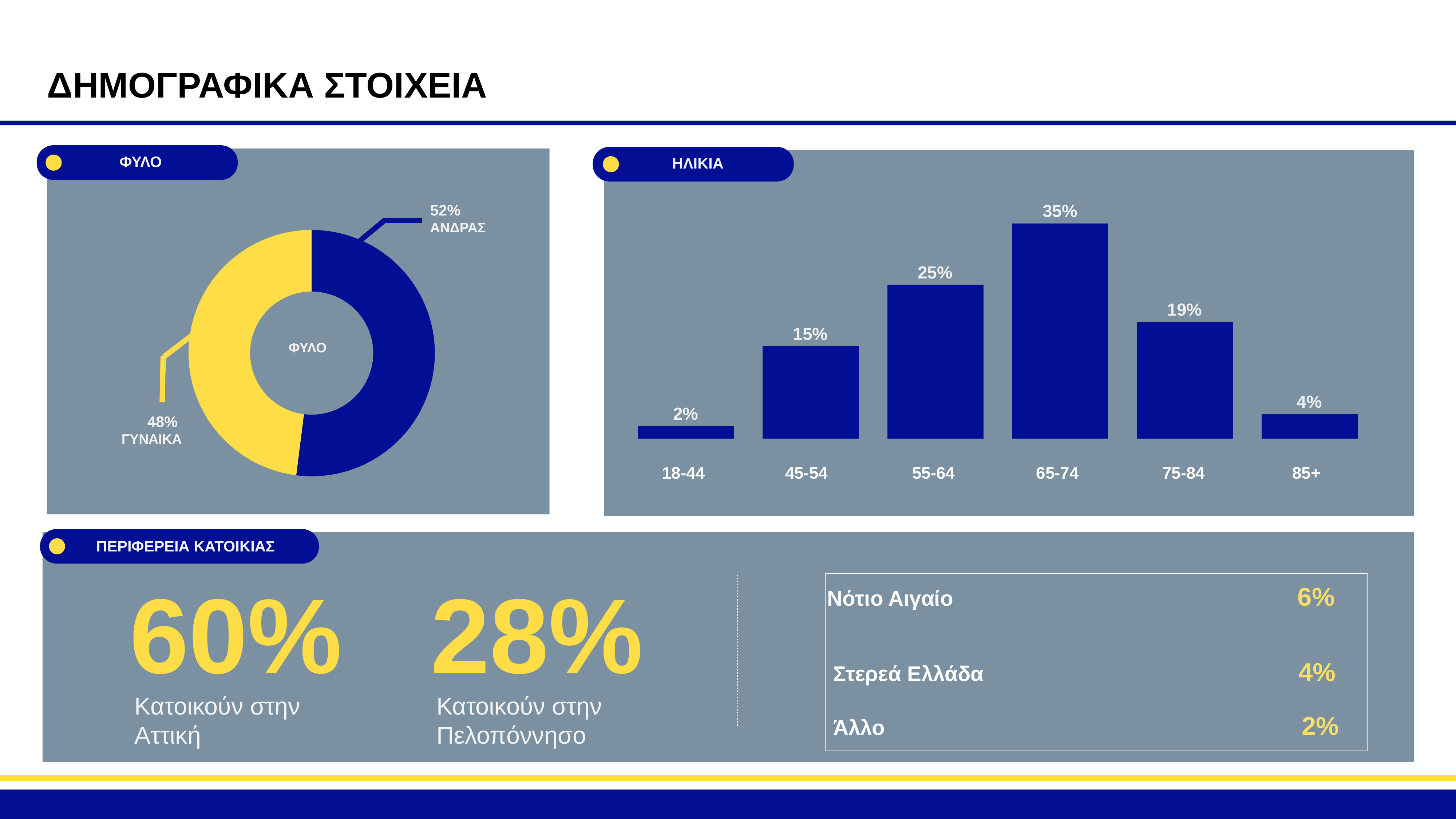
In the ΗΛΙΚΙΑ chart, which age group has the highest value? 65-74 In the ΦΥΛΟ chart, what percentage is ΓΥΝΑΙΚΑ? 48% In the ΦΥΛΟ chart, what percentage is ΑΝΔΡΑΣ? 52% In the ΗΛΙΚΙΑ chart, how many age groups are shown? 6 In the ΗΛΙΚΙΑ chart, what is the value for 65-74? 35% In the ΗΛΙΚΙΑ chart, what is the value for 45-54? 15% In the ΗΛΙΚΙΑ chart, which age group has the lowest value? 18-44 What kind of chart is the ΦΥΛΟ chart? Doughnut chart What kind of chart is the ΗΛΙΚΙΑ chart? Bar chart In the ΗΛΙΚΙΑ chart, what is the difference between the values for 55-64 and 75-84? 6% In the ΗΛΙΚΙΑ chart, which is larger, the value for 85+ or the value for 18-44? 85+ In the ΦΥΛΟ chart, which slice is larger, ΑΝΔΡΑΣ or ΓΥΝΑΙΚΑ? ΑΝΔΡΑΣ